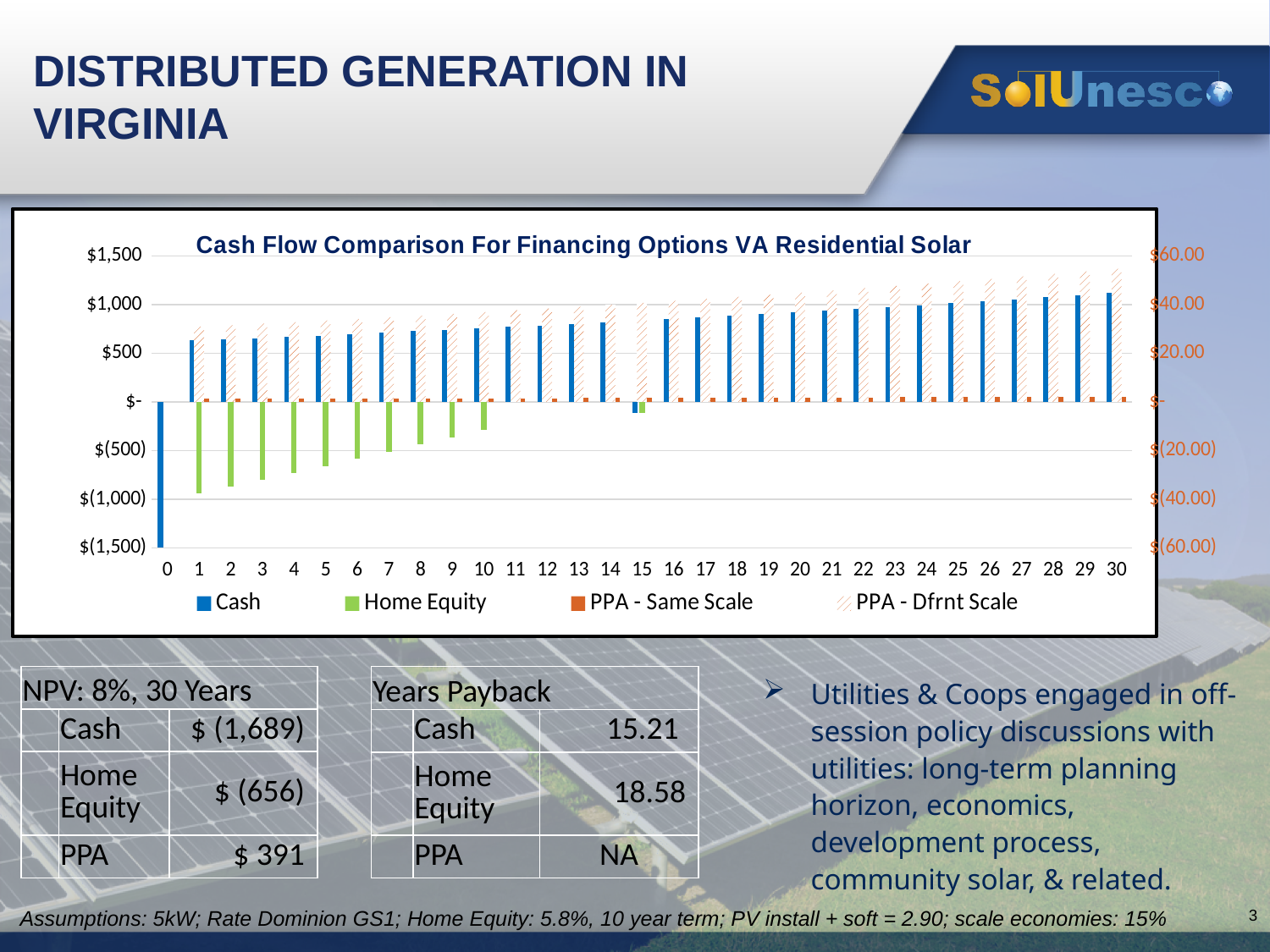
At year 1, which is larger: the Cash value or the Home Equity value? Cash Is the Cash value at year 0 greater or less than $(1,000)? less How many years (categories) are shown along the x axis of the chart? 31 What kind of chart is shown on the slide? bar chart Is the Home Equity value at year 10 greater or less than $(500)? greater Do the Cash values rise or fall from year 1 to year 30? rise What is the title of the chart? Cash Flow Comparison For Financing Options VA Residential Solar In which year is the Cash series at its lowest value? 0 How many series does the chart's legend list? 4 Is the Cash value at year 1 greater or less than $500? greater Which series in the chart is shown in green? Home Equity